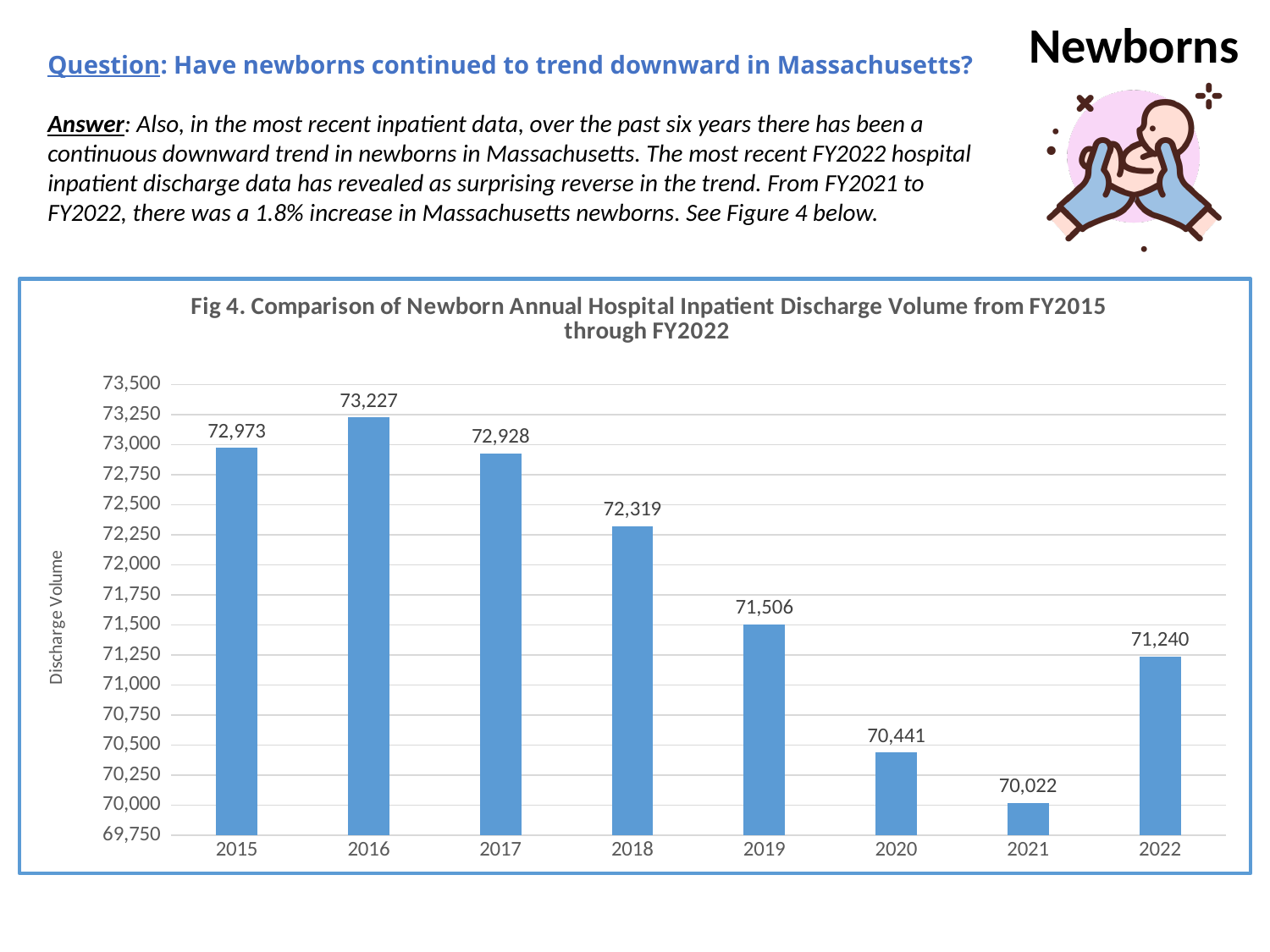
Which year has a larger discharge volume, 2017 or 2020? 2017 Which year has the highest discharge volume? 2016 Which year has the lowest discharge volume? 2021 What is the discharge volume for 2016? 73,227 How many years are shown on the chart? 8 What is the difference in discharge volume between 2015 and 2018? 654 What is the label on the vertical axis of the chart? Discharge Volume What is the discharge volume for 2021? 70,022 What is the difference in discharge volume between 2022 and 2021? 1,218 What is the discharge volume for 2019? 71,506 What kind of chart is shown on the slide? Bar chart Is the discharge volume for 2018 greater or less than 72,500? less